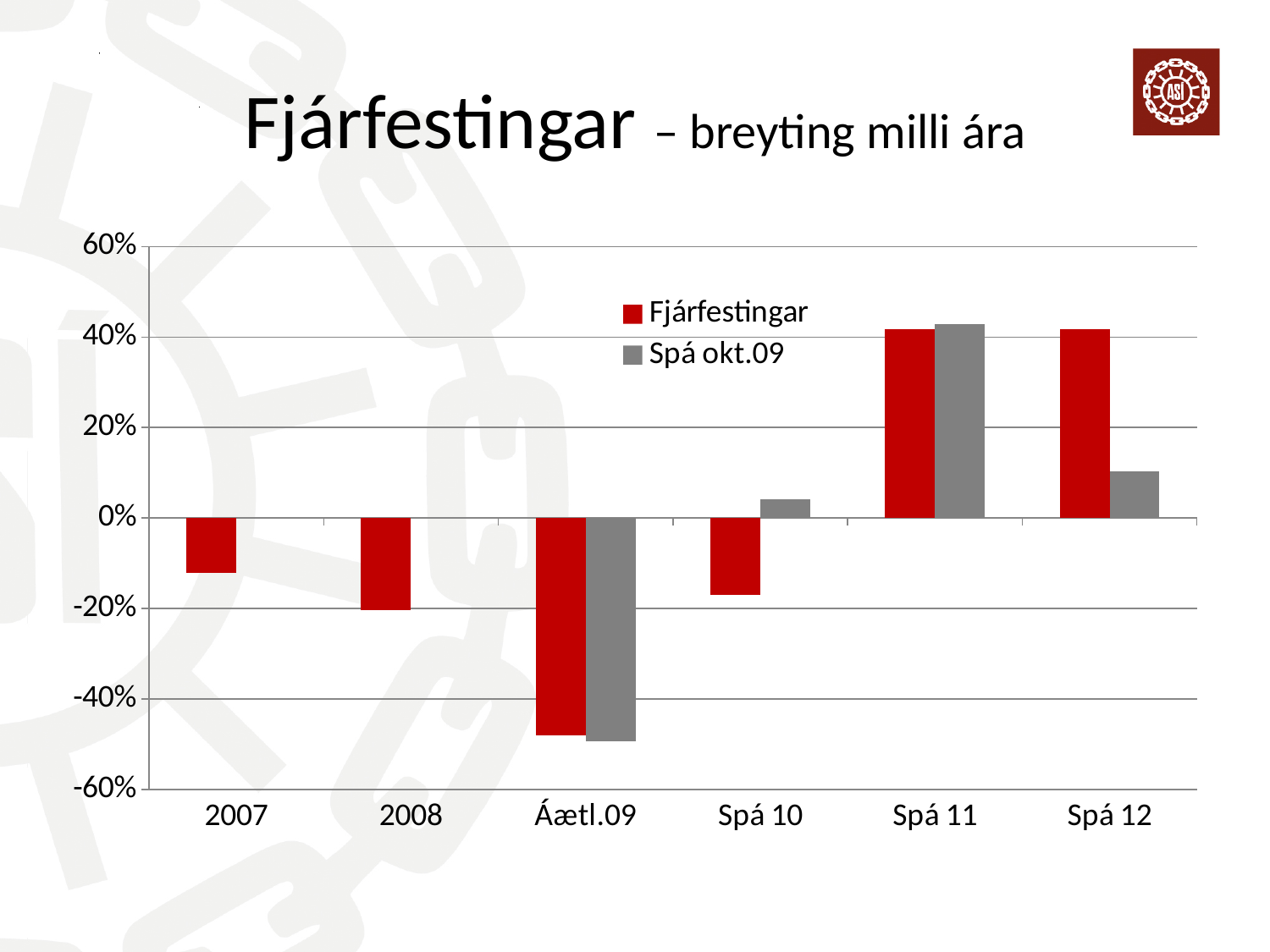
What kind of chart is shown on the slide? bar chart Which category has the lowest value for the Fjárfestingar series? Áætl.09 For Spá 12, which series has the larger value, Fjárfestingar or Spá okt.09? Fjárfestingar Is the Spá okt.09 value for Spá 10 greater or less than 0%? greater How many categories are shown on the x axis? 6 Is the Spá okt.09 value for Spá 12 greater or less than 20%? less How many series does the legend list? 2 For Spá 10, which series has the larger value, Fjárfestingar or Spá okt.09? Spá okt.09 Which category has the highest value for the Spá okt.09 series? Spá 11 Is the Fjárfestingar value for Áætl.09 greater or less than -40%? less What colour are the bars for the Spá okt.09 series? gray